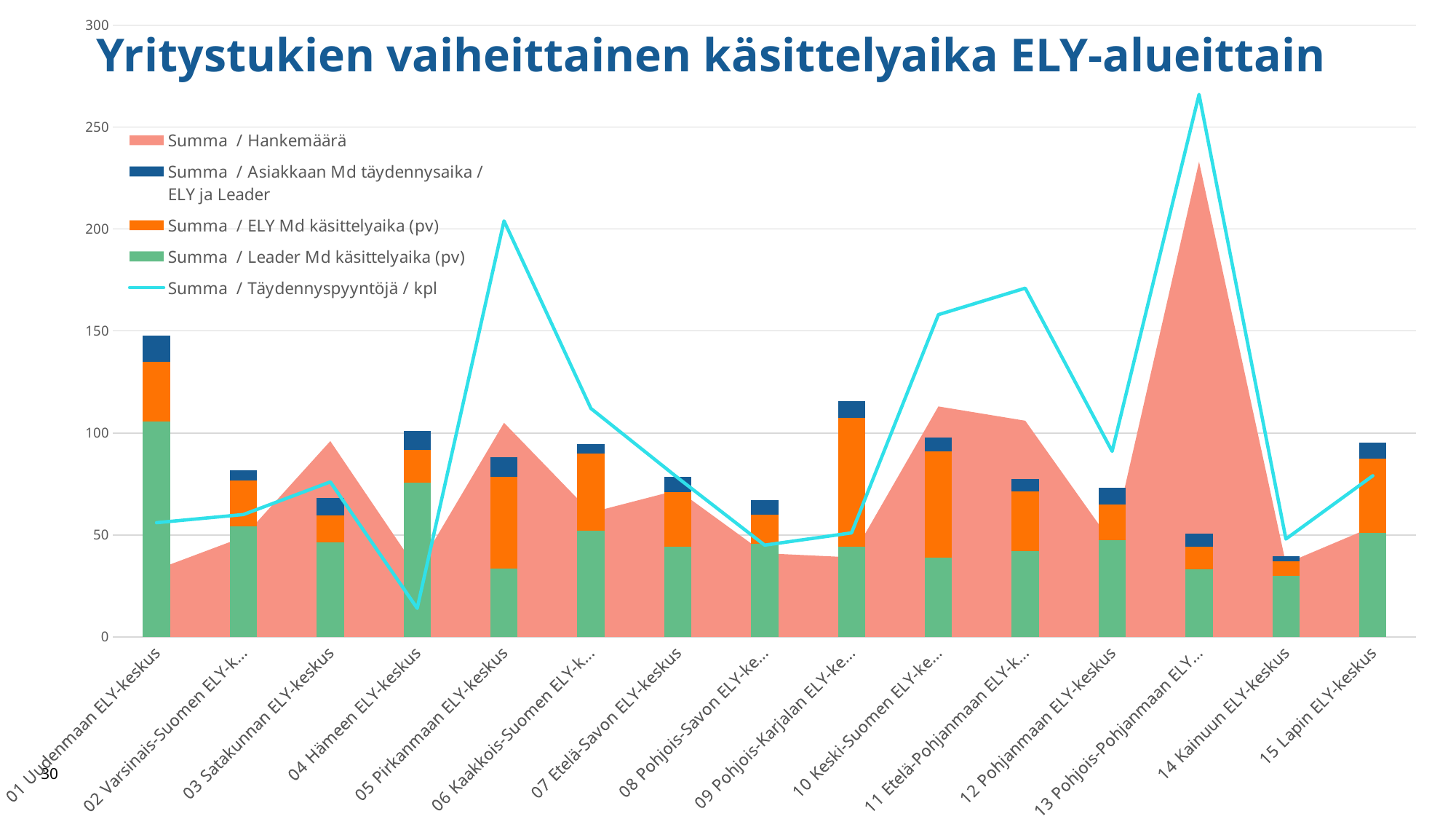
Does the Summa / Täydennyspyyntöjä / kpl line rise or fall from 09 Pohjois-Karjalan ELY-keskus to 11 Etelä-Pohjanmaan ELY-keskus? rise What kind of chart is this? A combination chart with stacked bars, an area and a line Which ELY-keskus has the largest Summa / Hankemäärä area value? 13 Pohjois-Pohjanmaan ELY-keskus Which series is drawn as a line rather than bars or an area? Summa / Täydennyspyyntöjä / kpl For which ELY-keskus does the Summa / Täydennyspyyntöjä / kpl line reach its highest point? 13 Pohjois-Pohjanmaan ELY-keskus Is the total stacked bar for 14 Kainuun ELY-keskus greater or less than 50? less Is the Summa / Täydennyspyyntöjä / kpl value for 13 Pohjois-Pohjanmaan ELY-keskus greater or less than 250? greater How many series does the legend list? 5 How many ELY-keskus categories are shown on the x axis? 15 What is the title of the chart? Yritystukien vaiheittainen käsittelyaika ELY-alueittain For which ELY-keskus does the Summa / Täydennyspyyntöjä / kpl line reach its lowest point? 04 Hämeen ELY-keskus Which ELY-keskus has the tallest stacked bar? 01 Uudenmaan ELY-keskus